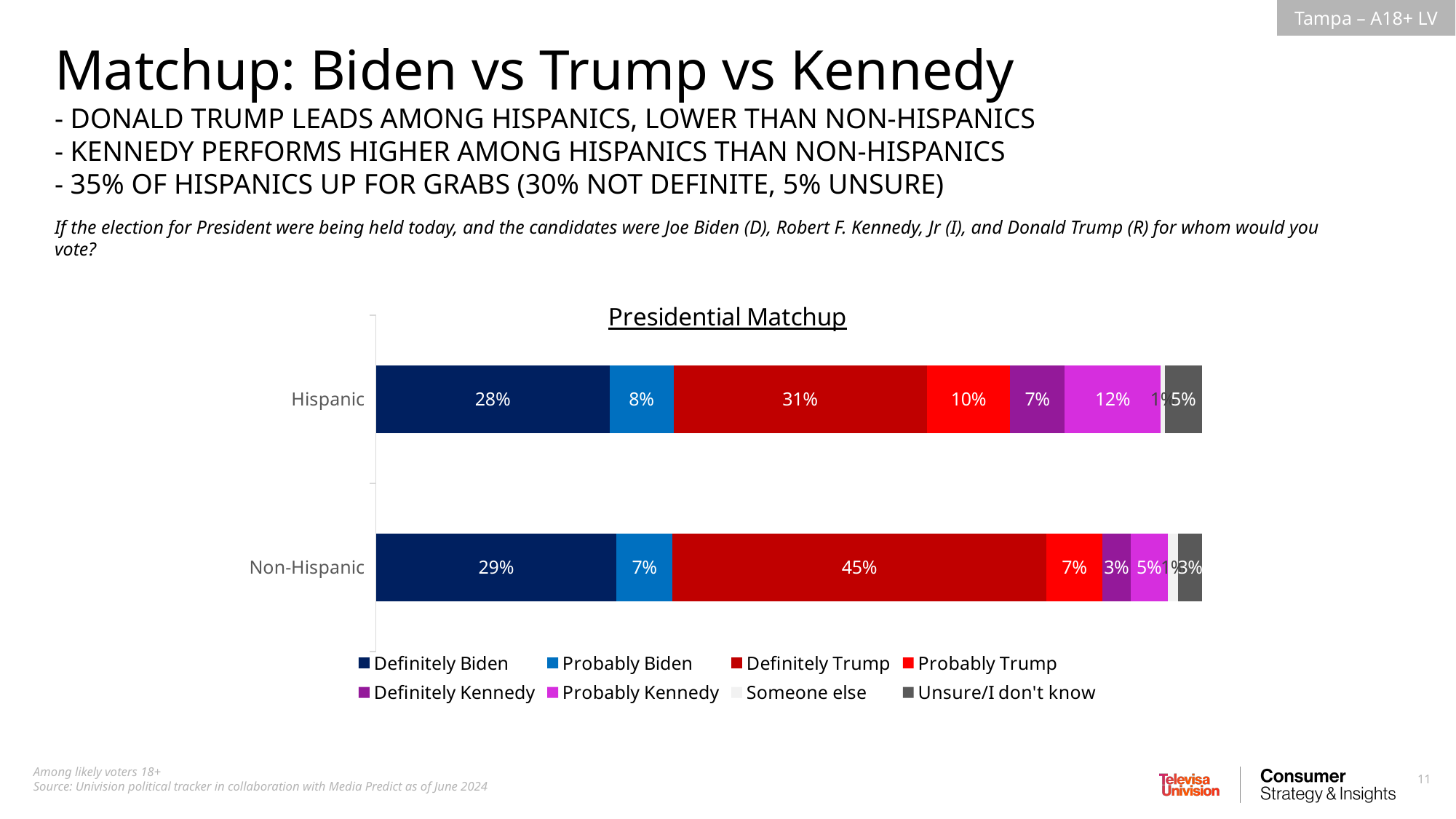
How many categories (bars) are shown in the Presidential Matchup chart? 2 What is the Definitely Trump value for Hispanic voters? 31% How many series does the legend of the Presidential Matchup chart list? 8 What is the Unsure/I don't know value for Hispanic voters? 5% What is the Definitely Trump value for Non-Hispanic voters? 45% What is the Definitely Biden value for Non-Hispanic voters? 29% What is the title of the chart? Presidential Matchup What kind of chart is the Presidential Matchup chart? Stacked bar chart Which group has the larger Probably Trump value, Hispanic or Non-Hispanic? Hispanic Which segment is the largest in the Hispanic bar? Definitely Trump What is the difference between the Definitely Trump values for Non-Hispanic and Hispanic voters? 14% What is the Probably Kennedy value for Hispanic voters? 12%